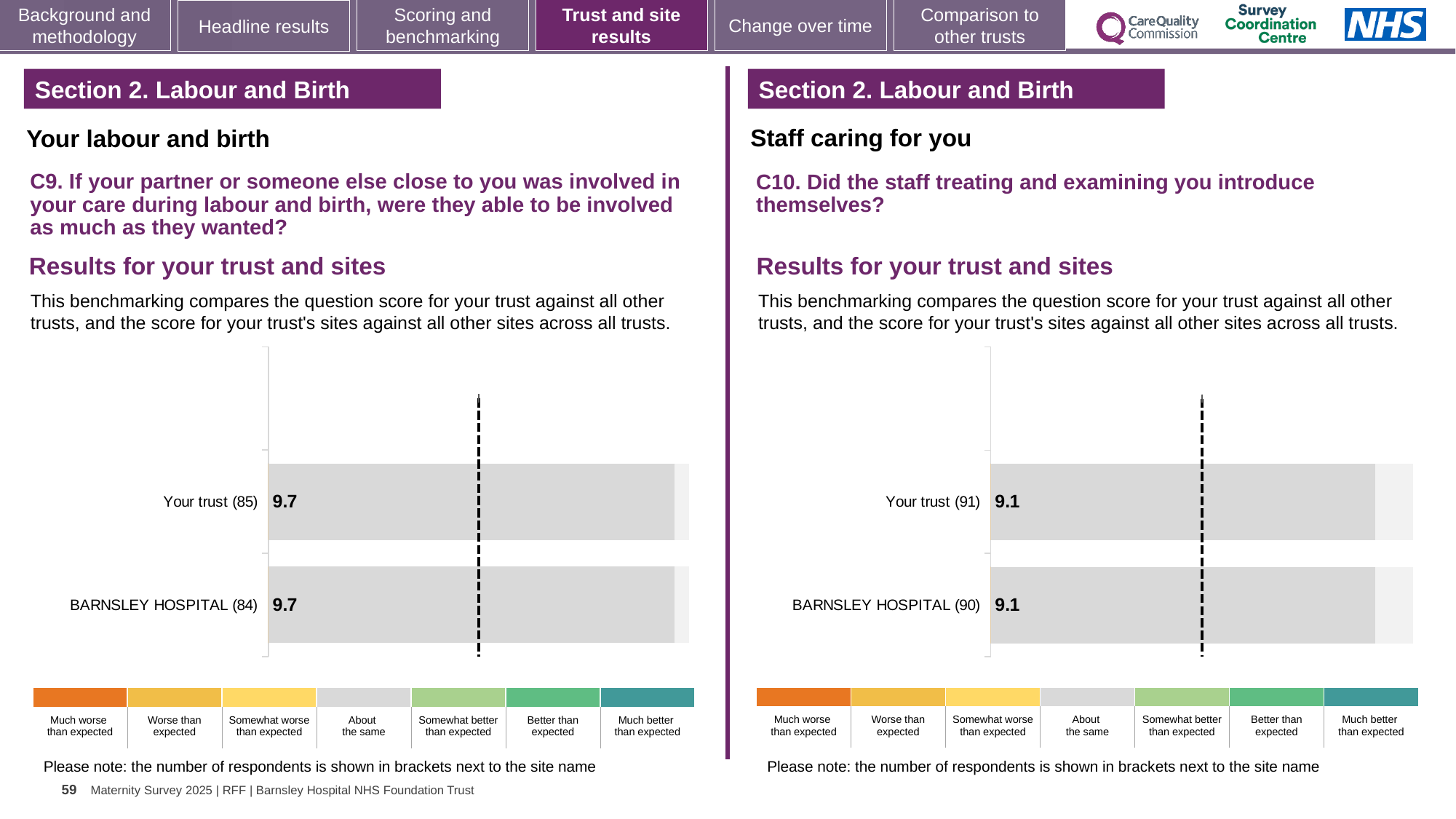
On the left chart (C9), what is the score for BARNSLEY HOSPITAL? 9.7 On the right chart (C10), how many respondents are shown in brackets for BARNSLEY HOSPITAL? 90 On the left chart (C9), how many respondents are shown in brackets for Your trust? 85 On the right chart (C10), what is the score for BARNSLEY HOSPITAL? 9.1 On the left chart (C9), what is the score for Your trust? 9.7 What kind of chart is used on the left (C9)? Bar chart On the right chart (C10), what is the difference between the Your trust score and the BARNSLEY HOSPITAL score? 0 On the right chart (C10), what is the score for Your trust? 9.1 On the left chart (C9), what is the difference between the Your trust score and the BARNSLEY HOSPITAL score? 0 How many categories does the colour key below each chart list, from 'Much worse than expected' to 'Much better than expected'? 7 How many bars are plotted on the right chart (C10)? 2 How many bars are plotted on the left chart (C9)? 2